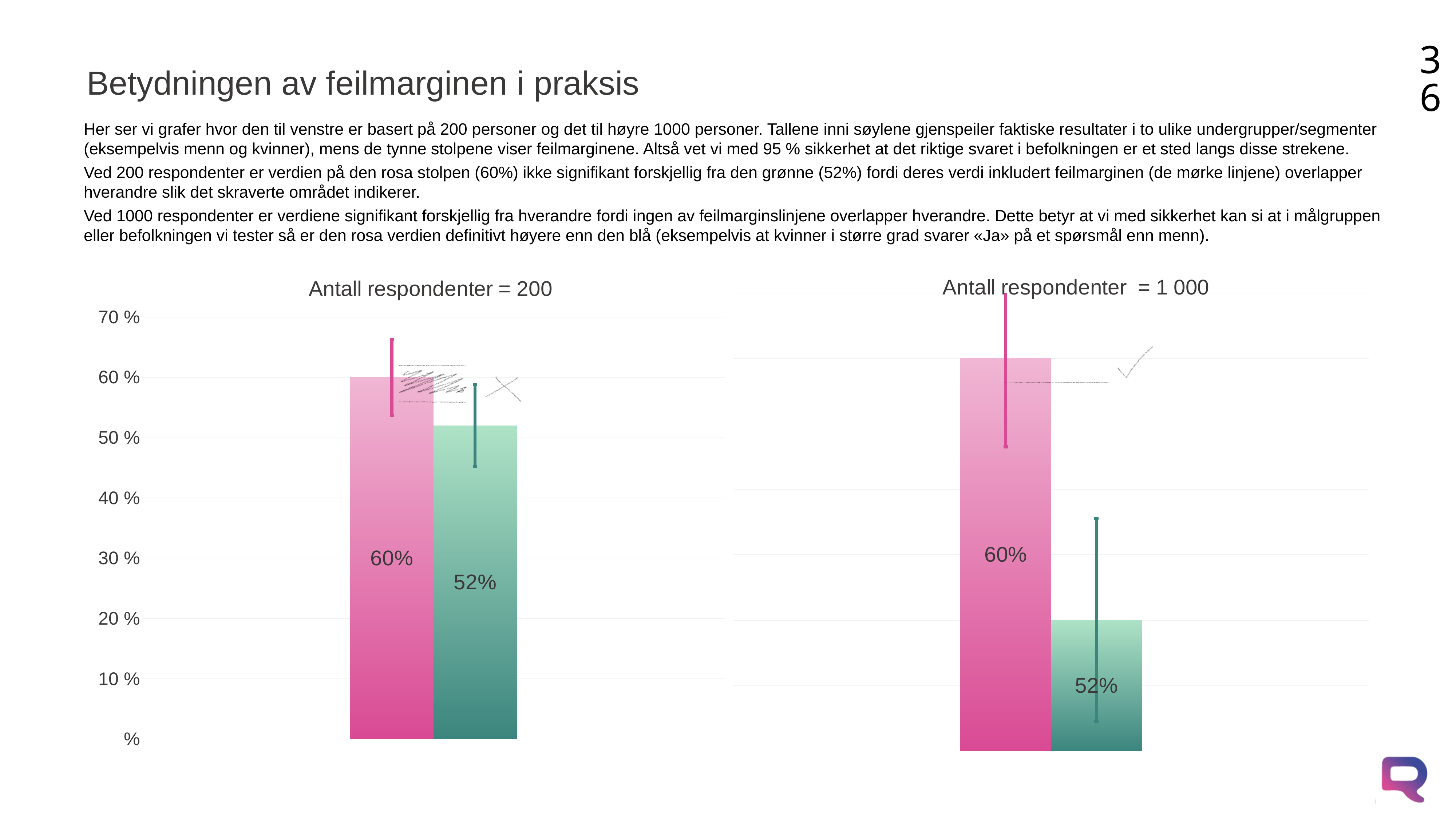
In the chart titled "Antall respondenter = 1 000", what value is printed on the pink bar? 60% What is the title of the chart on the right of the slide? Antall respondenter = 1 000 In the chart titled "Antall respondenter = 200", which bar has the lowest value? the green bar In the chart titled "Antall respondenter = 1 000", what value is printed on the green bar? 52% In the chart titled "Antall respondenter = 200", what value is printed on the green bar? 52% In the chart titled "Antall respondenter = 200", is the value of the pink bar greater or less than 50 %? greater In the chart titled "Antall respondenter = 200", what is the difference between the pink bar's value and the green bar's value? 8% In the chart titled "Antall respondenter = 200", is the value of the green bar greater or less than 60 %? less What kind of chart is the chart on the left of the slide? bar chart How many bars are plotted in the chart titled "Antall respondenter = 1 000"? 2 In the chart titled "Antall respondenter = 200", which bar is higher, the pink one or the green one? the pink bar In the chart titled "Antall respondenter = 200", what value is printed on the pink bar? 60%